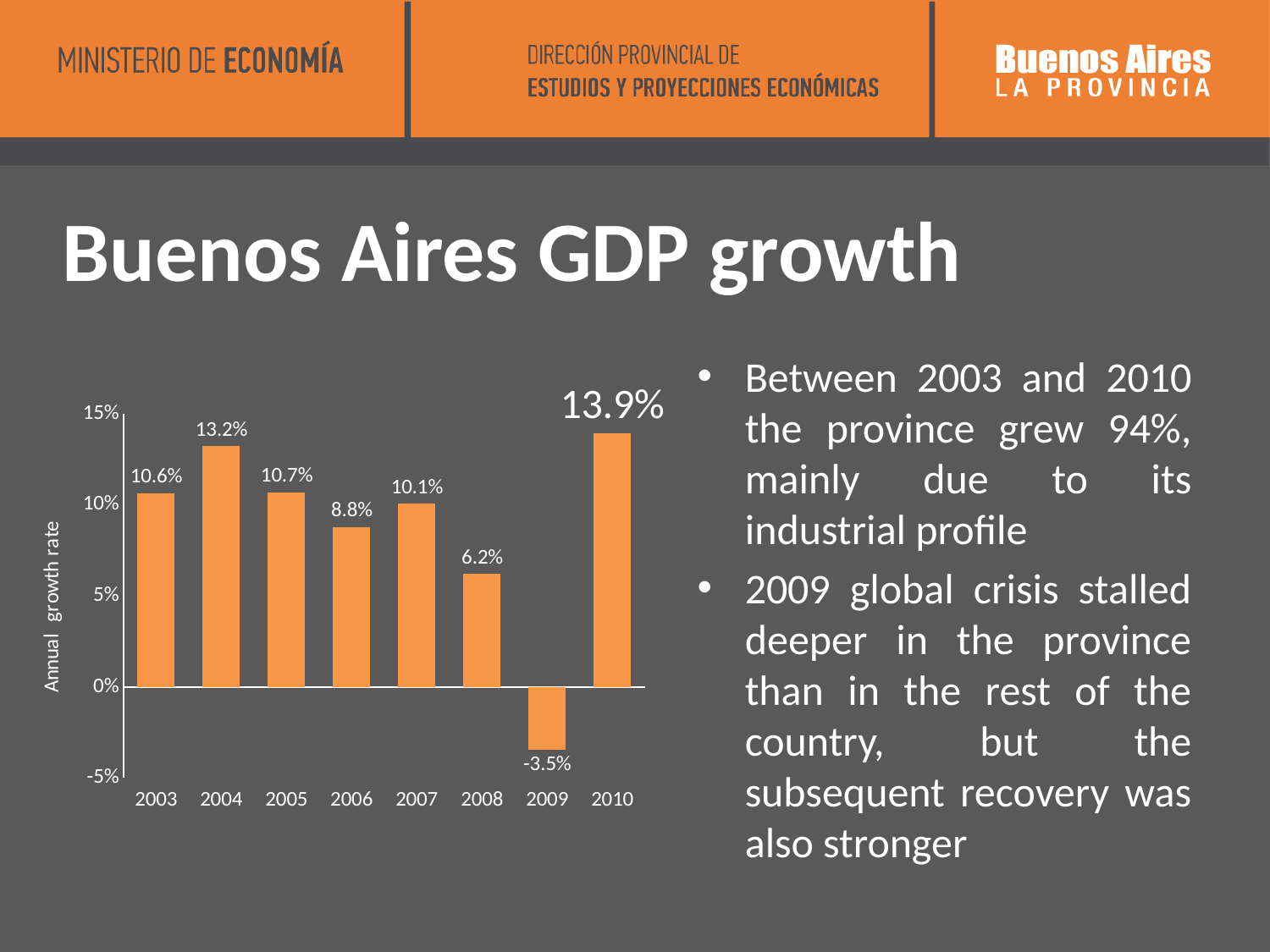
Which year had the highest annual growth rate? 2010 What kind of chart is shown on the slide? Bar chart What is the label on the vertical axis of the chart? Annual growth rate How many years are shown on the x axis? 8 What is the difference between the growth rates in 2010 and 2009? 17.4% What was the annual growth rate in 2004? 13.2% Is the value for 2005 greater or less than 10%? greater Did the growth rate rise or fall from 2007 to 2009? Fall Which year had the lowest annual growth rate? 2009 What was the annual growth rate in 2009? -3.5% What was the annual growth rate in 2008? 6.2% Which year had a higher growth rate, 2006 or 2007? 2007